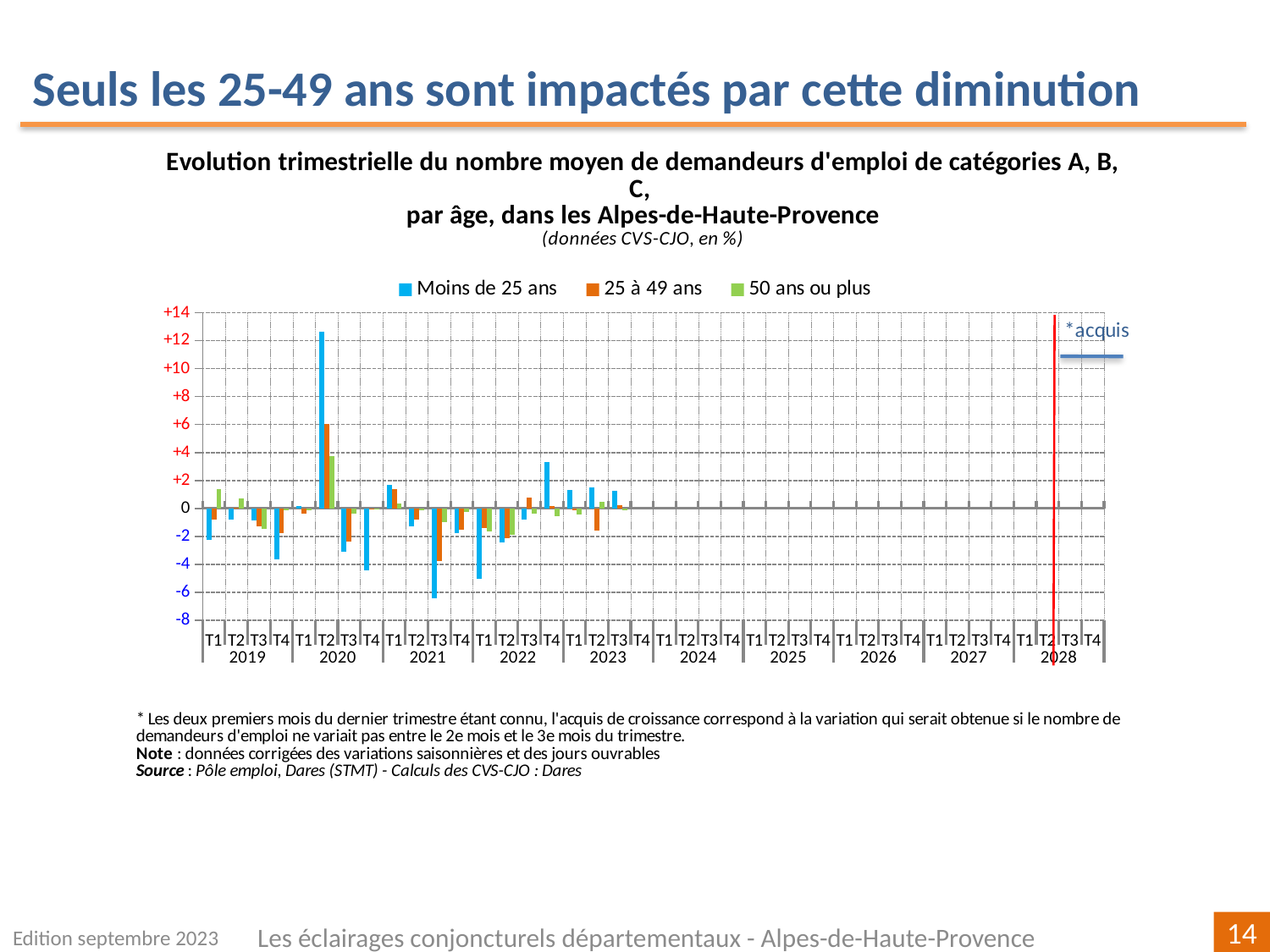
In T2 2020, which series has the larger value: 'Moins de 25 ans' or '25 à 49 ans'? Moins de 25 ans What does the red vertical line near the right of the chart mark, according to the label next to it? acquis Is the value for '25 à 49 ans' in T2 2020 greater or less than +4? greater Is the value for 'Moins de 25 ans' in T2 2020 greater or less than +10? greater How many series does the legend list? 3 In which quarter does the 'Moins de 25 ans' series reach its highest value? T2 2020 What kind of chart is shown on the slide? bar chart Which series is shown in blue in the legend? Moins de 25 ans Is the value for 'Moins de 25 ans' in T4 2022 greater or less than +2? greater How many years are labelled along the x axis? 10 In which quarter does the 'Moins de 25 ans' series reach its lowest value? T3 2021